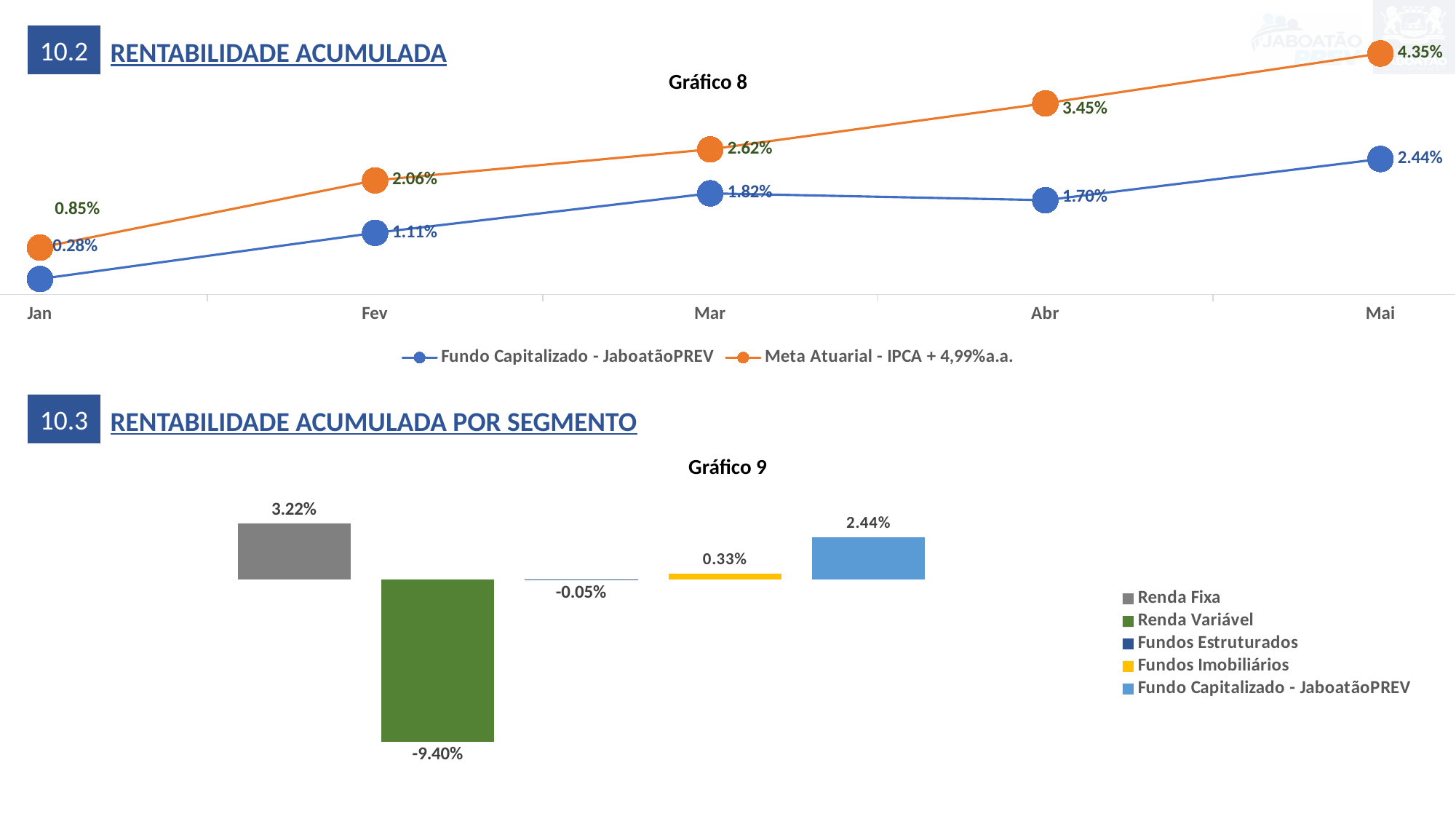
In Gráfico 8, how many series does the legend list? 2 In Gráfico 9, how many segments are plotted? 5 In Gráfico 8, what is the difference between Meta Atuarial and Fundo Capitalizado in Abr? 1.75% In Gráfico 8, which series has the higher value in Fev? Meta Atuarial - IPCA + 4,99%a.a. What kind of chart is Gráfico 8? line chart In Gráfico 8, does the Meta Atuarial series rise or fall from Jan to Mai? rise In Gráfico 8, what is the value for Meta Atuarial - IPCA + 4,99%a.a. in Mai? 4.35% What kind of chart is Gráfico 9? bar chart In Gráfico 9, which segment has the lowest value? Renda Variável In Gráfico 9, what is the value for Renda Variável? -9.40% In Gráfico 8, what is the value for Fundo Capitalizado - JaboatãoPREV in Mar? 1.82% In Gráfico 9, which segment has the highest value? Renda Fixa